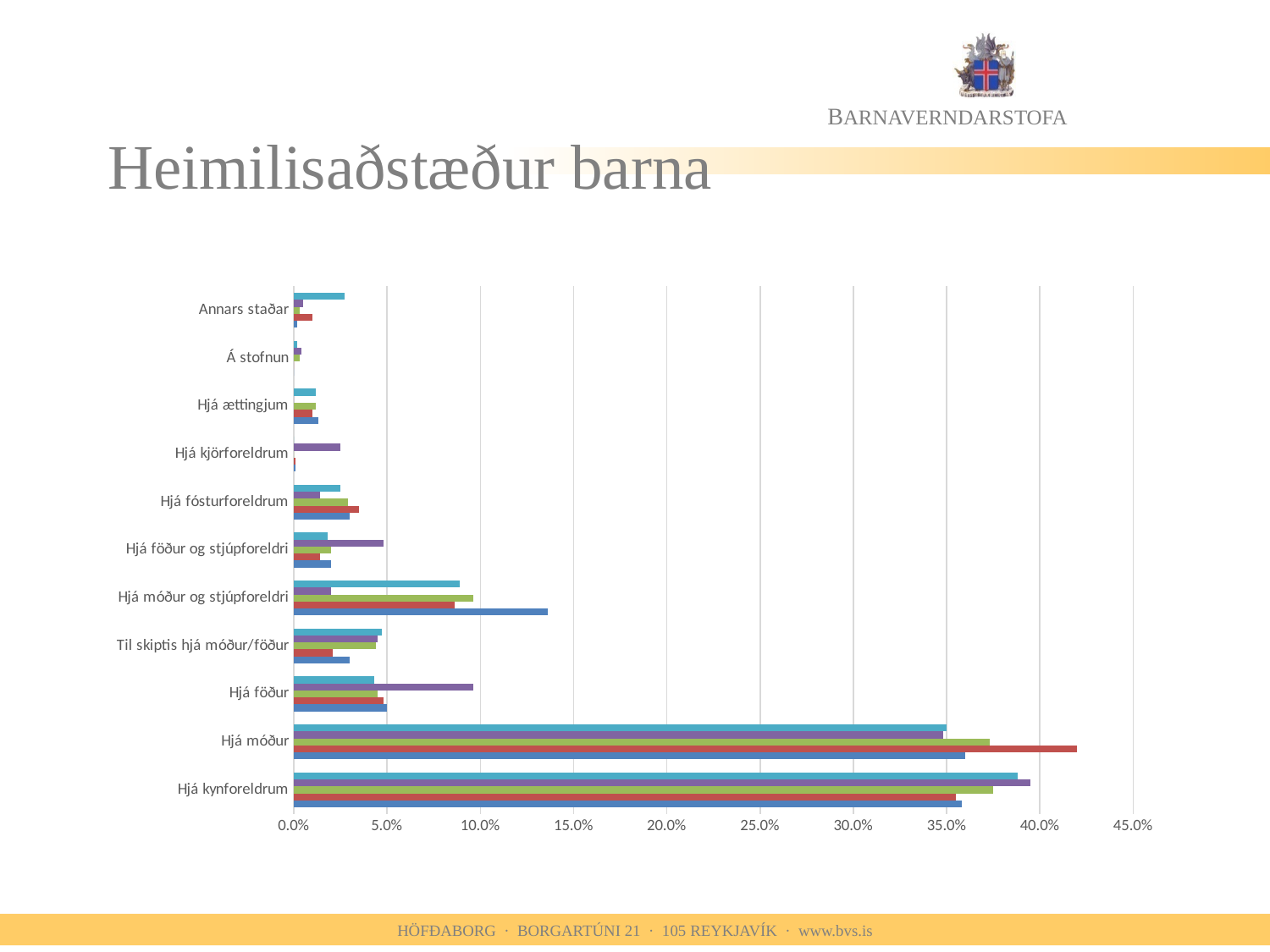
Are all the bars for Annars staðar greater or less than 5.0%? less What is the highest value shown on the horizontal axis of the chart? 45.0% Which category has the longest bar in the chart? Hjá móður Is the longest bar for Hjá móður greater or less than 40.0%? greater What kind of chart is shown on the slide? bar chart How many bars (series) are plotted for each category in the chart? 5 Which category has longer bars overall, Hjá móður og stjúpforeldri or Hjá föður og stjúpforeldri? Hjá móður og stjúpforeldri Which category has longer bars overall, Hjá móður or Hjá föður? Hjá móður What is the title of the slide containing the chart? Heimilisaðstæður barna Is the longest bar for Hjá móður og stjúpforeldri greater or less than 10.0%? greater How many categories are listed on the vertical axis of the chart? 11